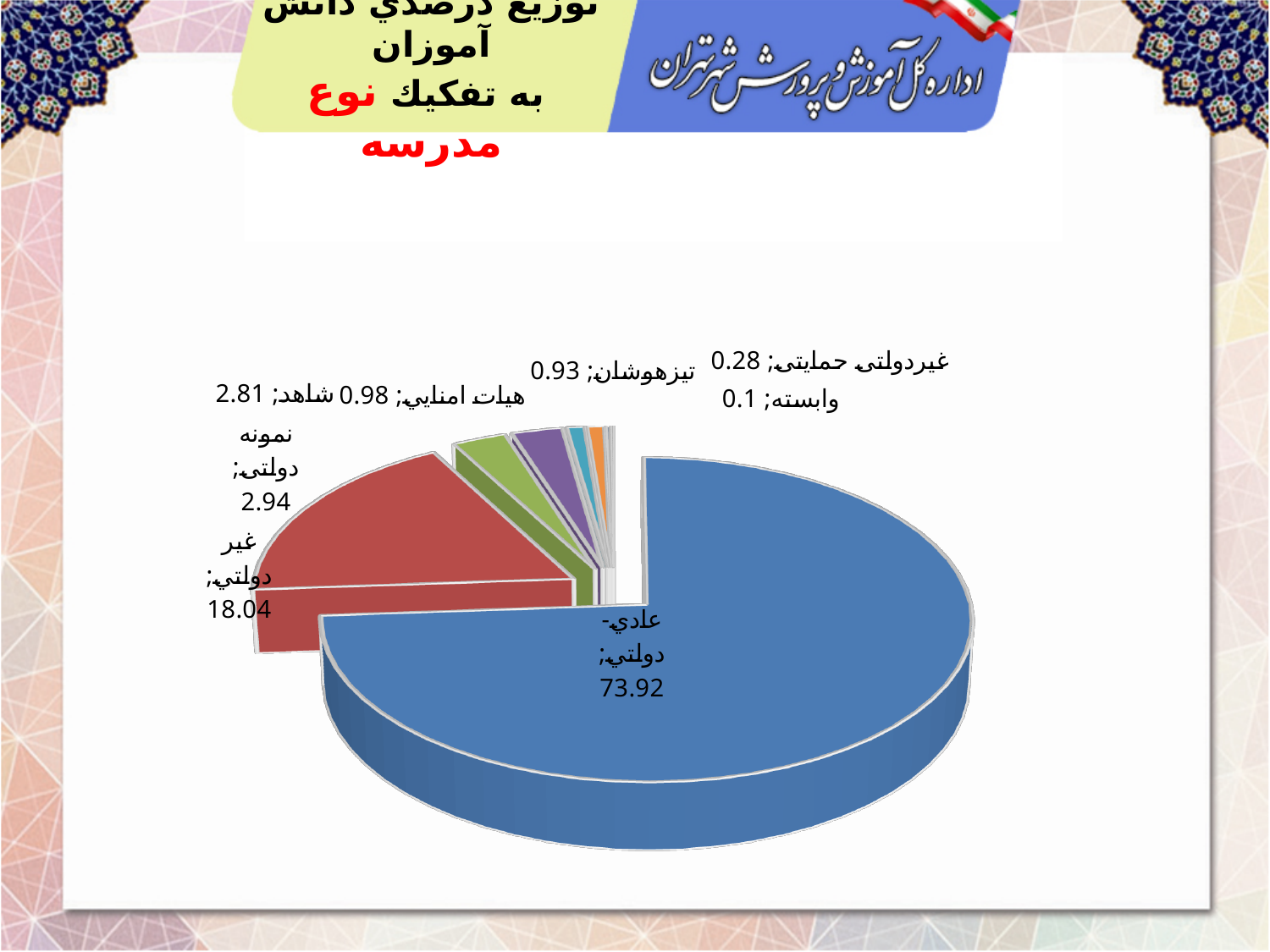
What is the value shown for تيزهوشان? 0.93 What is the difference between the values for نمونه دولتي and شاهد? 0.13 What is the difference between the values for عادي-دولتي and غير دولتي? 55.88 What kind of chart is shown on the slide? pie chart Which category has the largest slice of the pie? عادي-دولتي What is the value shown for عادي-دولتي? 73.92 How many slices does the pie chart have? 8 What is the value shown for نمونه دولتي? 2.94 Which is larger, the value for شاهد or the value for هيات امنايي? شاهد Which category has the smallest slice of the pie? وابسته What is the value shown for وابسته? 0.1 What is the value shown for غير دولتي? 18.04